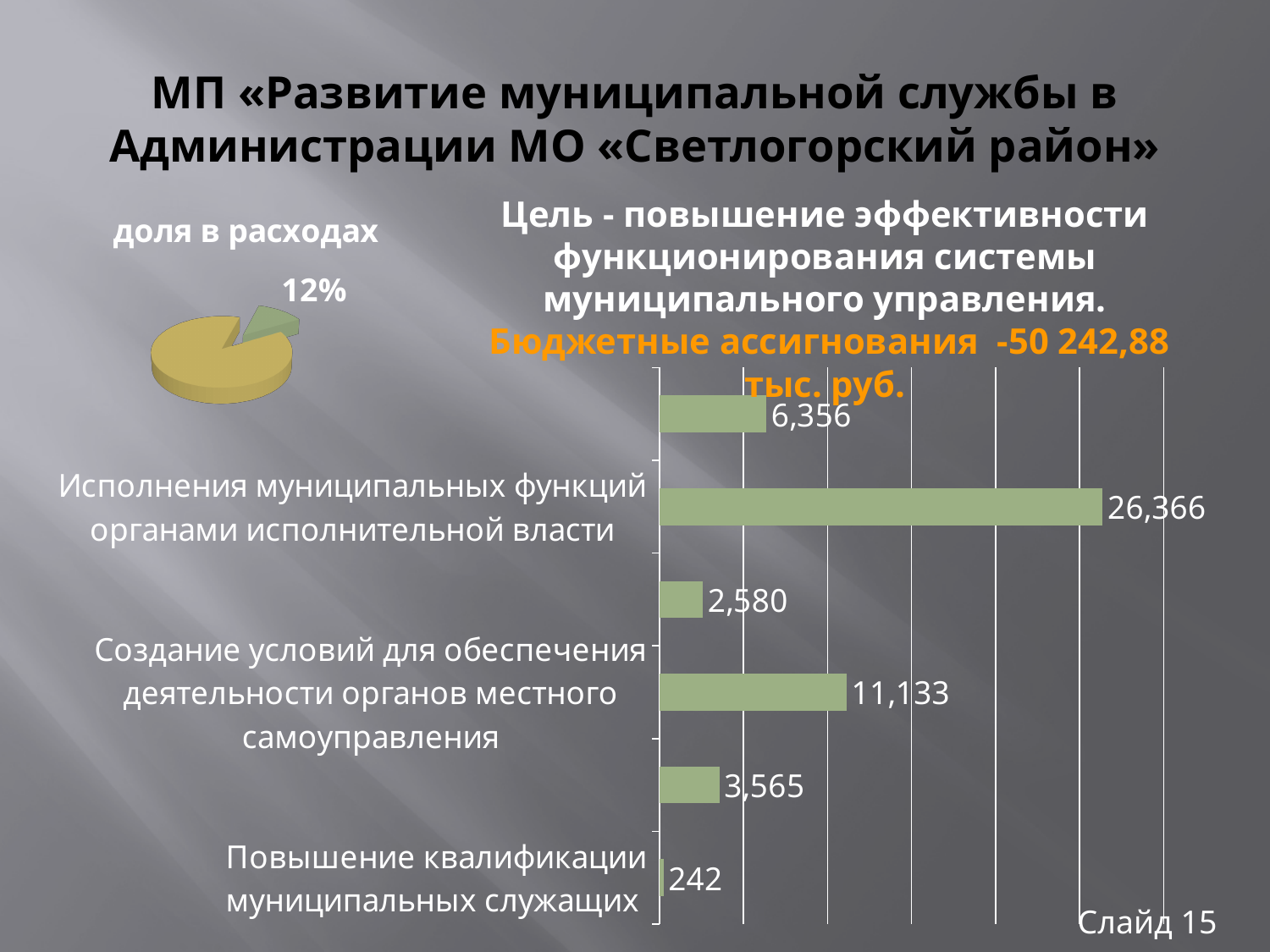
In the bar chart on the right, what is the value of the largest bar? 26,366 What type of chart is the chart on the right side of the slide? bar chart In the bar chart on the right, what is the value of the topmost bar? 6,356 In the bar chart on the right, what is the value of the smallest bar? 242 In the bar chart on the right, what is the difference between the bars labelled 3,565 and 2,580? 985 How many bars are plotted in the bar chart on the right? 6 In the bar chart on the right, which is larger: the bar labelled 6,356 or the bar labelled 3,565? 6,356 In the pie chart «доля в расходах», what share is shown for the small slice? 12% In the bar chart on the right, what is the difference between the largest bar (26,366) and the bar labelled 11,133? 15,233 What is the total budget allocation (Бюджетные ассигнования) stated on the slide? 50 242,88 тыс. руб. What type of chart is the chart titled «доля в расходах»? pie chart In the bar chart on the right, what is the value of the bottom bar? 242